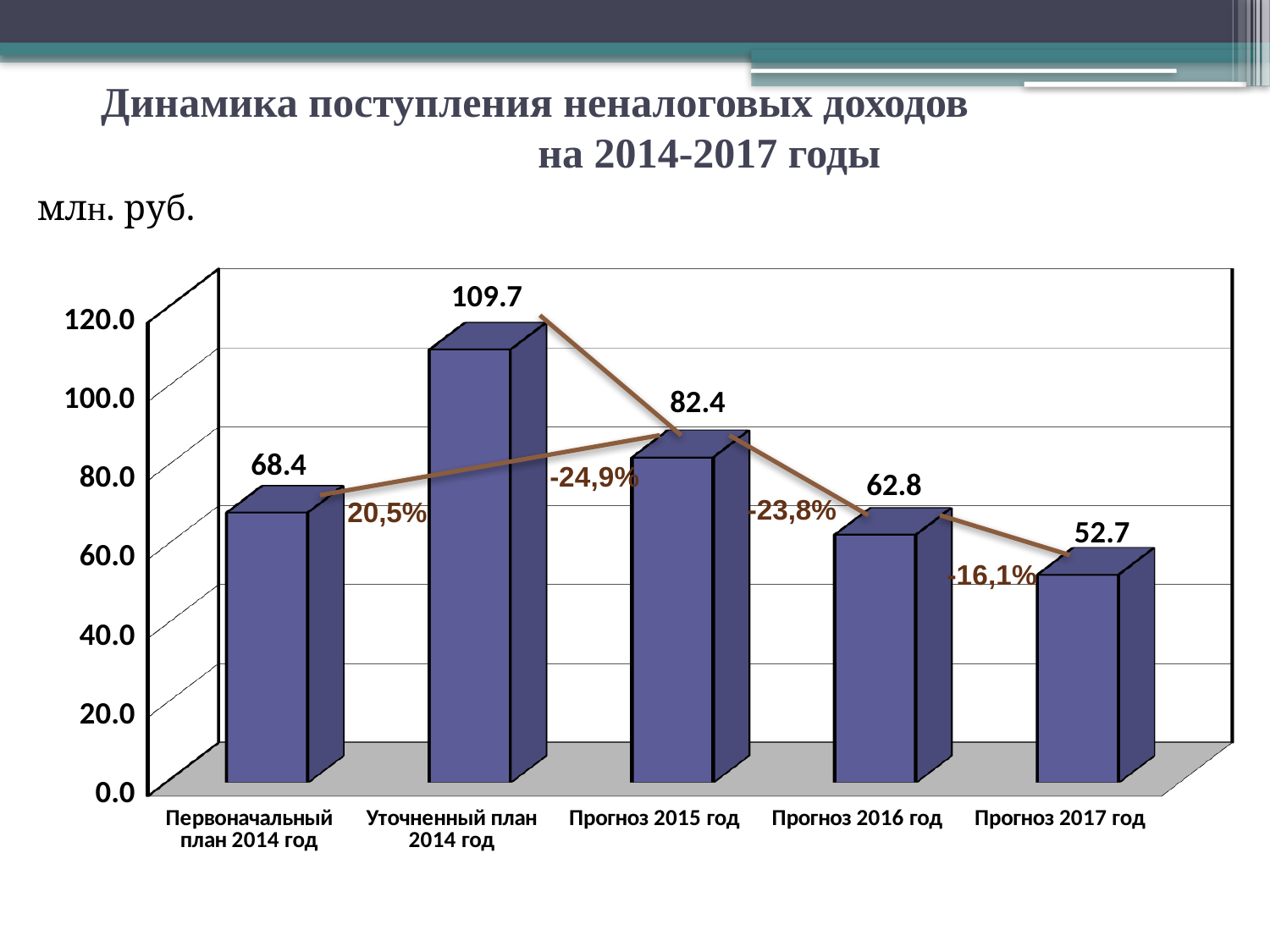
What kind of chart is shown on the slide? Bar chart What is the value for Первоначальный план 2014 год? 68.4 Which is larger, the value for Первоначальный план 2014 год or Прогноз 2016 год? Первоначальный план 2014 год What is the value for Уточненный план 2014 год? 109.7 Do the values rise or fall from Уточненный план 2014 год to Прогноз 2017 год? Fall What unit is stated for the chart values? млн. руб. What is the value for Прогноз 2017 год? 52.7 Which category has the lowest value? Прогноз 2017 год How many categories are shown on the chart? 5 What is the difference between the values for Прогноз 2015 год and Прогноз 2016 год? 19.6 What percentage change is labelled between Прогноз 2016 год and Прогноз 2017 год? -16,1% Which category has the highest value? Уточненный план 2014 год